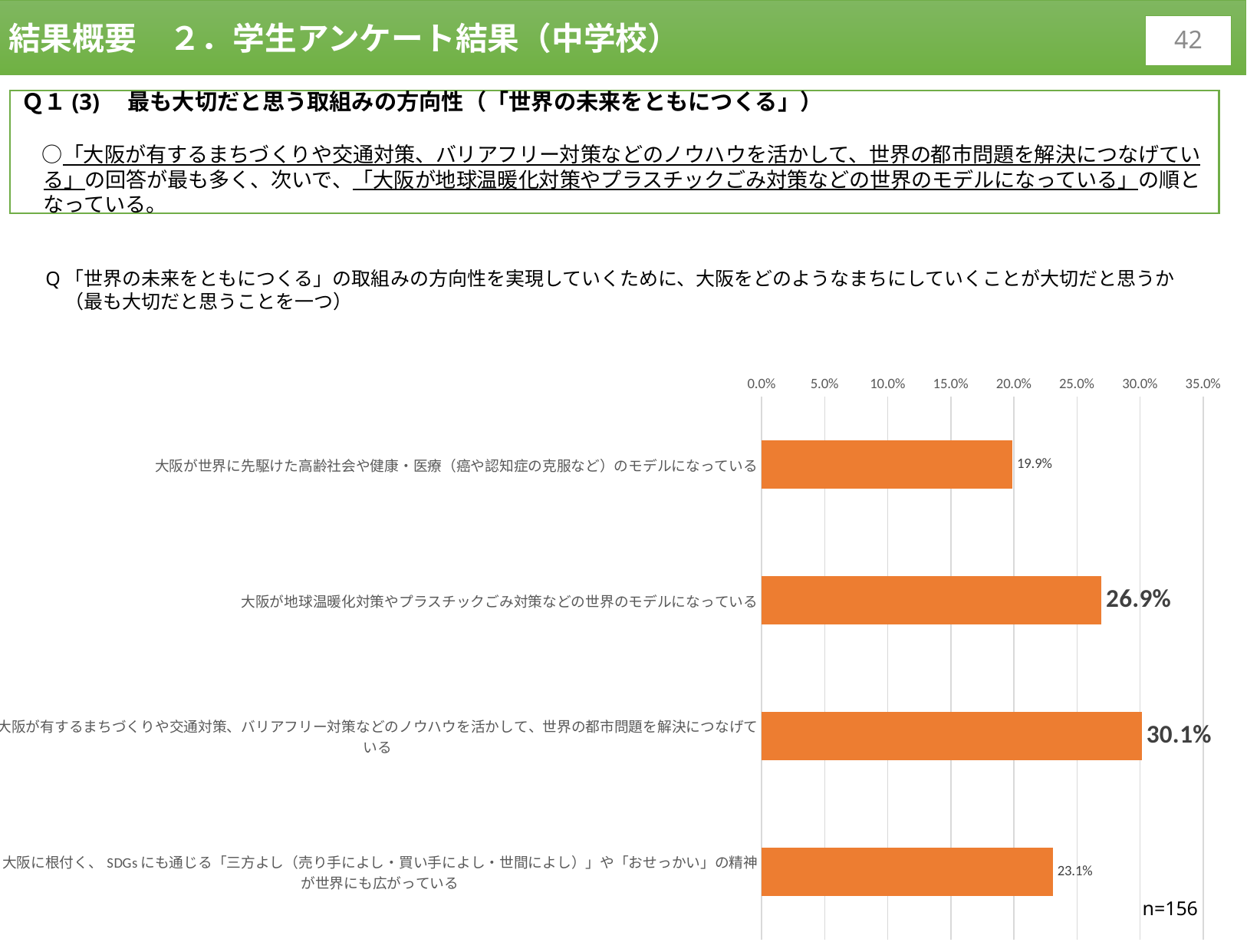
What kind of chart is shown on the slide? bar chart Which is larger: the value for 「大阪が地球温暖化対策やプラスチックごみ対策などの世界のモデルになっている」 or the value for 「大阪に根付く、SDGsにも通じる「三方よし」や「おせっかい」の精神が世界にも広がっている」? 大阪が地球温暖化対策やプラスチックごみ対策などの世界のモデルになっている What is the value for 「大阪が世界に先駆けた高齢社会や健康・医療（癌や認知症の克服など）のモデルになっている」? 19.9% Is the value for 「大阪が地球温暖化対策やプラスチックごみ対策などの世界のモデルになっている」 greater or less than 25.0%? greater What is the value for 「大阪が地球温暖化対策やプラスチックごみ対策などの世界のモデルになっている」? 26.9% Which category has the lowest value in the chart? 大阪が世界に先駆けた高齢社会や健康・医療（癌や認知症の克服など）のモデルになっている What is the difference between the highest value (30.1%) and the second highest value (26.9%)? 3.2% Which category has the highest value in the chart? 大阪が有するまちづくりや交通対策、バリアフリー対策などのノウハウを活かして、世界の都市問題を解決につなげている What is the value for 「大阪が有するまちづくりや交通対策、バリアフリー対策などのノウハウを活かして、世界の都市問題を解決につなげている」? 30.1% How many categories (response options) are plotted in the chart? 4 What is the value for 「大阪に根付く、SDGsにも通じる「三方よし」や「おせっかい」の精神が世界にも広がっている」? 23.1% What is the sample size (n) shown next to the chart? n=156